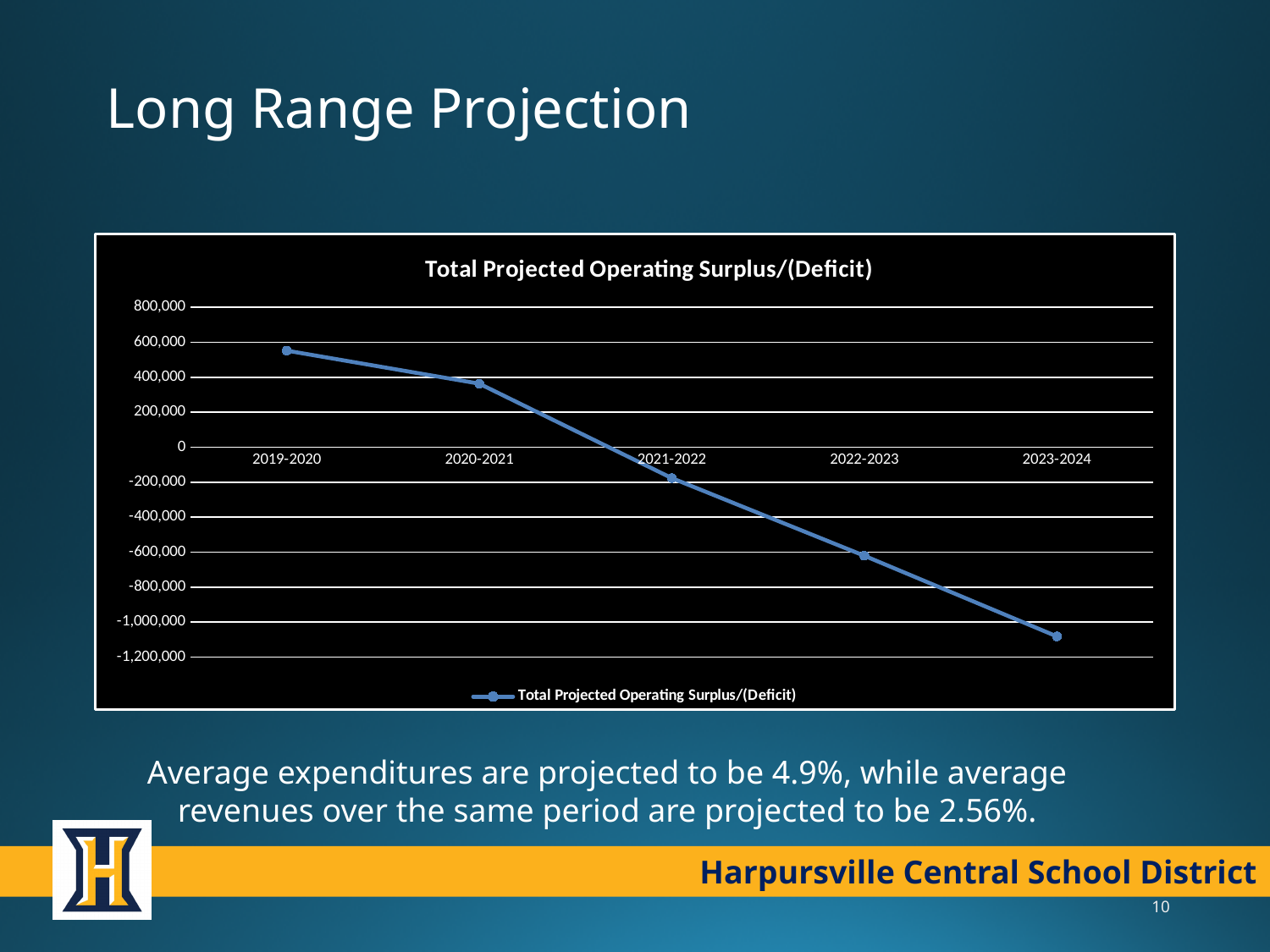
Is the value for 2020-2021 greater or less than 200,000? greater What is the title of the chart? Total Projected Operating Surplus/(Deficit) Which school year has the highest projected operating surplus/(deficit)? 2019-2020 Is the value for 2019-2020 greater or less than 400,000? greater Do the values rise or fall from 2019-2020 to 2023-2024? Fall How many school years are plotted on the x axis of the chart? 5 Is the value for 2021-2022 greater or less than 0? less What kind of chart is shown on the slide? Line chart Which school year has the lowest projected operating surplus/(deficit)? 2023-2024 Which is larger, the value for 2020-2021 or the value for 2022-2023? 2020-2021 How many series does the chart's legend list? 1